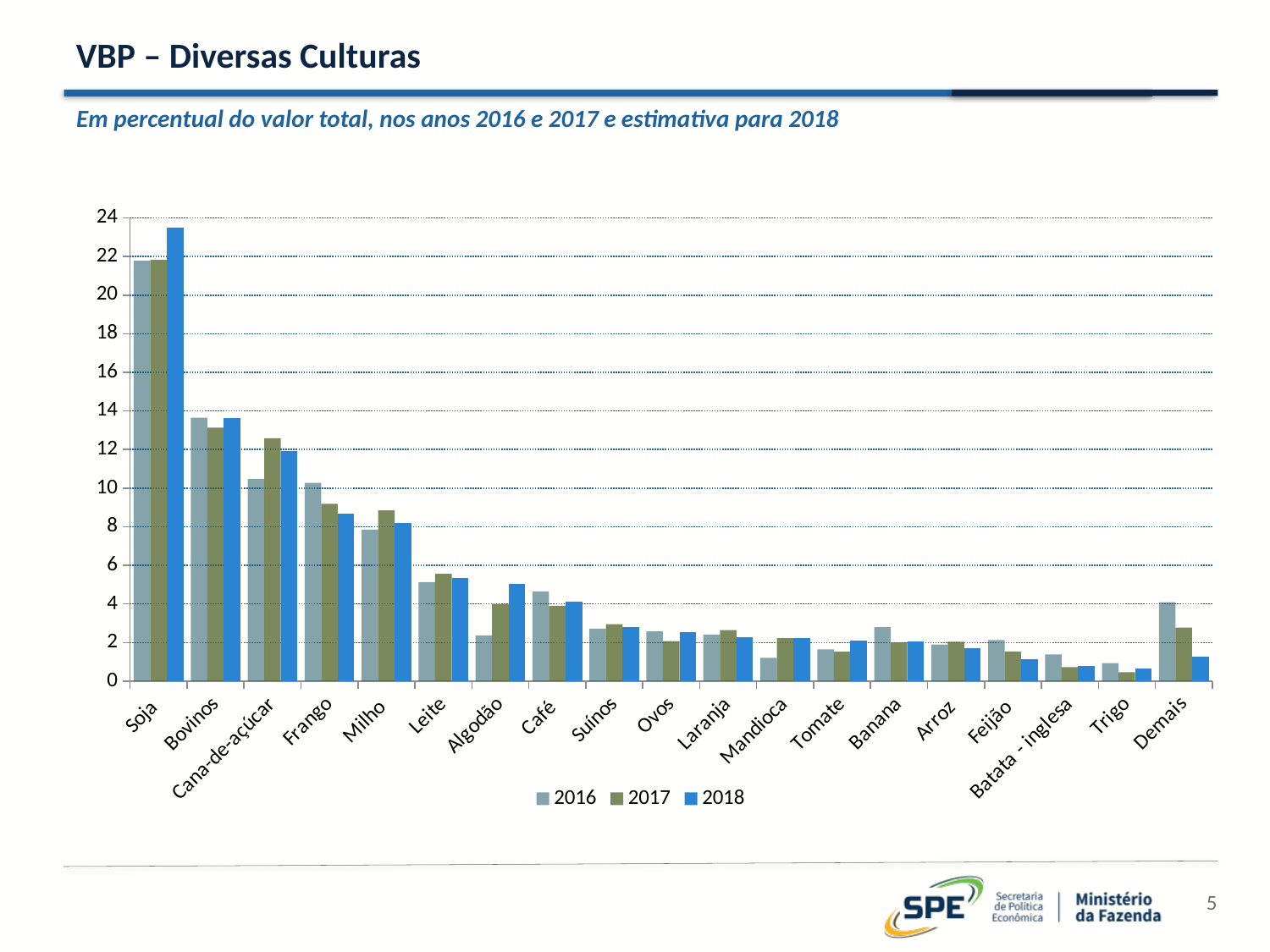
For Algodão, which is larger: the 2016 value or the 2018 value? 2018 Is the value for Demais in 2018 greater or less than 2? less For Cana-de-açúcar, which is larger: the 2016 value or the 2017 value? 2017 Is the value for Leite in 2016 greater or less than 4? greater How many series does the legend list? 3 Which category has the lowest value for 2017? Trigo Is the value for Bovinos in 2017 greater or less than 12? greater What kind of chart is shown on the slide? bar chart How many categories are shown on the x axis? 19 Do the 2016 values generally rise or fall along the x axis from Soja to Trigo? fall Which category has the highest value for 2018? Soja